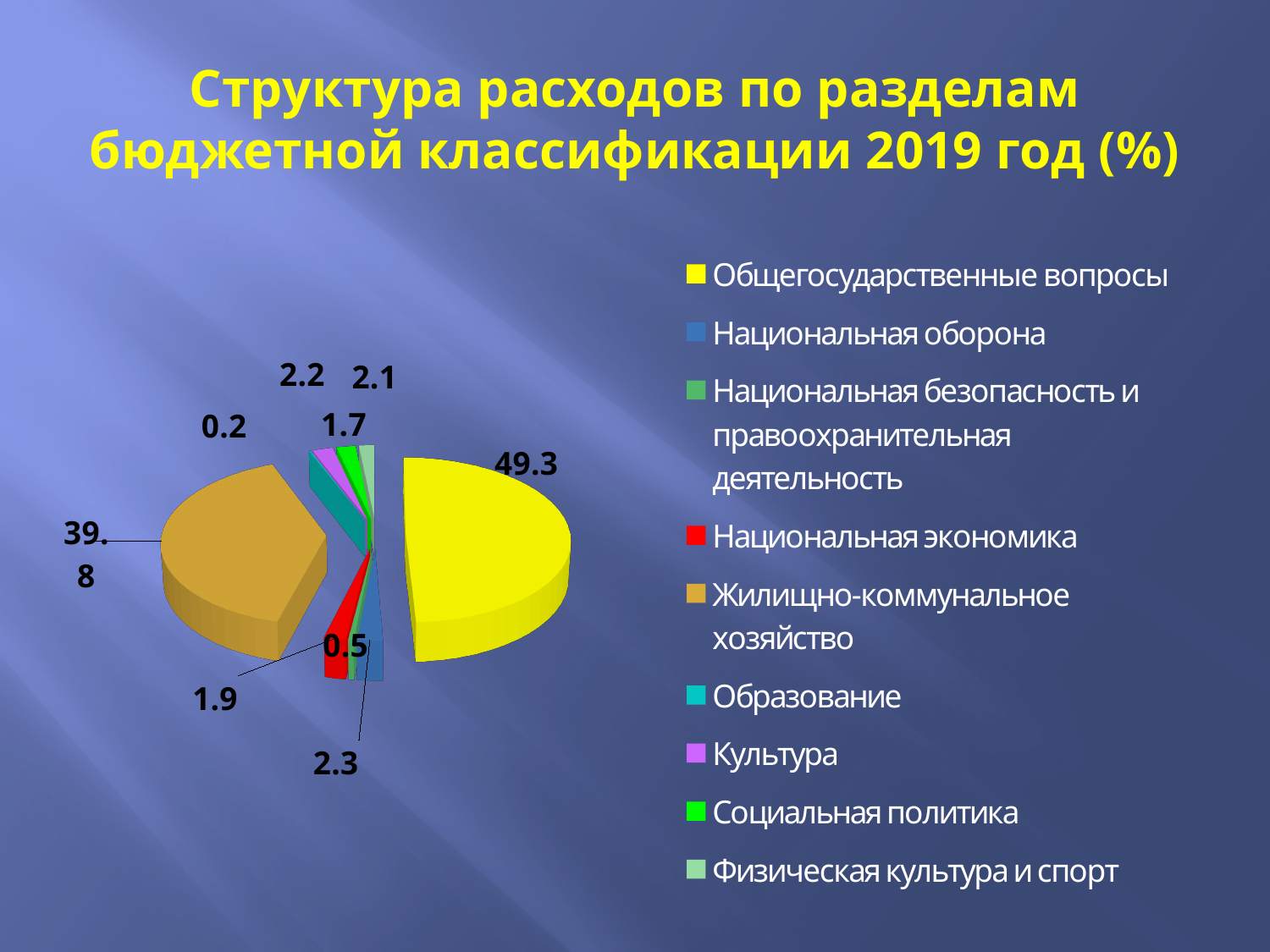
What kind of chart is shown on the slide? pie chart What is the smallest value labelled on the pie chart? 0.2 What is the value shown for Общегосударственные вопросы? 49.3 How many categories does the legend list? 9 What is the combined share of Общегосударственные вопросы and Жилищно-коммунальное хозяйство? 89.1 How many slices are labelled with values in the pie chart? 9 What is the title of the chart slide? Структура расходов по разделам бюджетной классификации 2019 год (%) What colour represents Национальная экономика in the legend? red Which category has the largest share of expenditures? Общегосударственные вопросы What is the value shown for Жилищно-коммунальное хозяйство? 39.8 Which is larger: the share for Общегосударственные вопросы or for Жилищно-коммунальное хозяйство? Общегосударственные вопросы What is the difference between the values for Общегосударственные вопросы and Жилищно-коммунальное хозяйство? 9.5